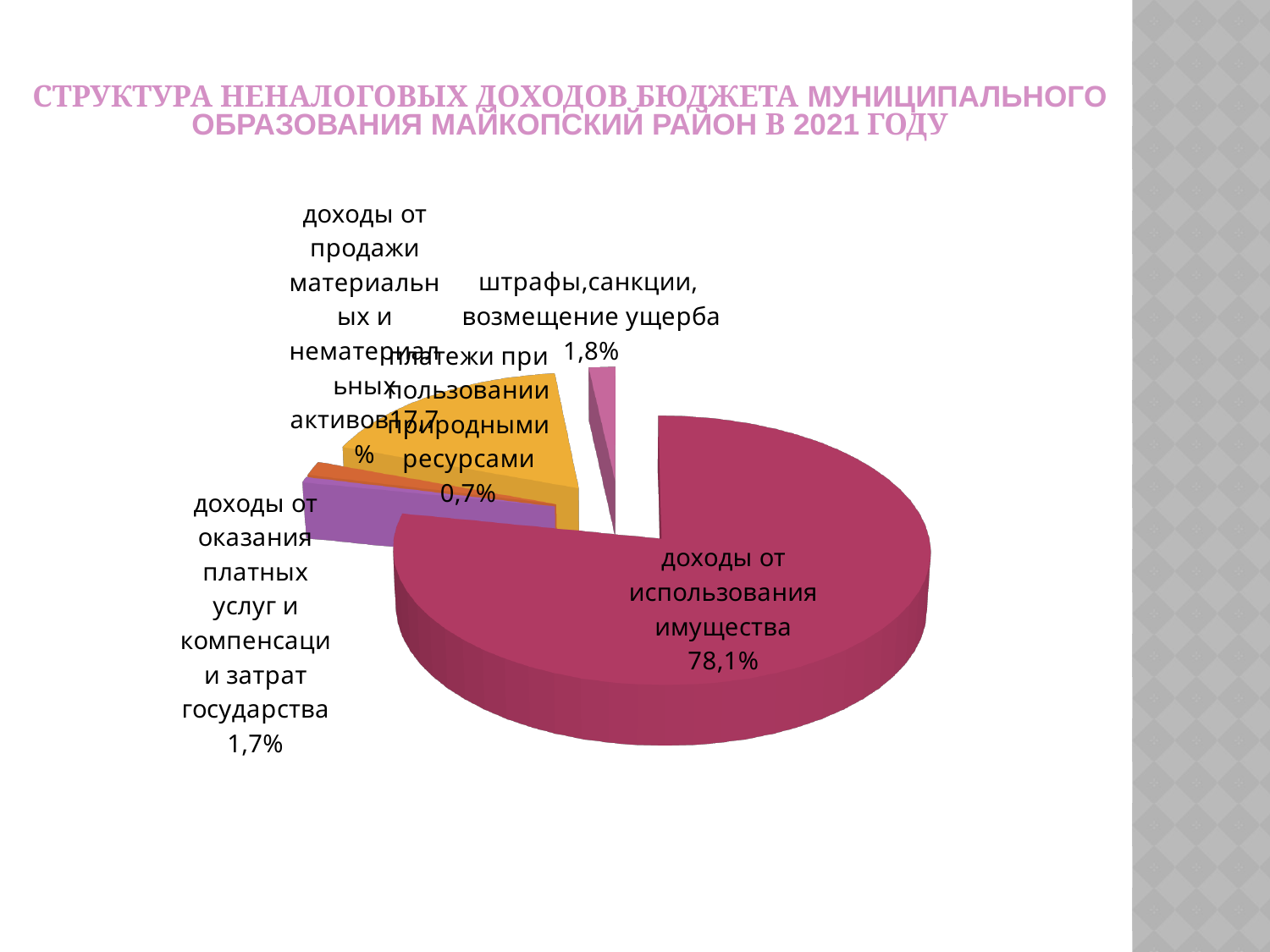
What share of the pie is 'доходы от продажи материальных и нематериальных активов'? 17,7% Which category has the largest share of the pie? доходы от использования имущества What value is shown for 'платежи при пользовании природными ресурсами'? 0,7% What value is shown for 'доходы от оказания платных услуг и компенсации затрат государства'? 1,7% Which is larger: the share for 'доходы от продажи материальных и нематериальных активов' or for 'штрафы,санкции, возмещение ущерба'? доходы от продажи материальных и нематериальных активов What share of the pie is 'доходы от использования имущества'? 78,1% Which category has the smallest share of the pie? платежи при пользовании природными ресурсами How many slices does the pie chart have? 5 What kind of chart is shown on the slide? pie chart What is the difference in percentage points between 'доходы от использования имущества' and 'доходы от продажи материальных и нематериальных активов'? 60,4 What is the title of the chart on the slide? Структура неналоговых доходов бюджета муниципального образования Майкопский район в 2021 году What value is shown for 'штрафы,санкции, возмещение ущерба'? 1,8%